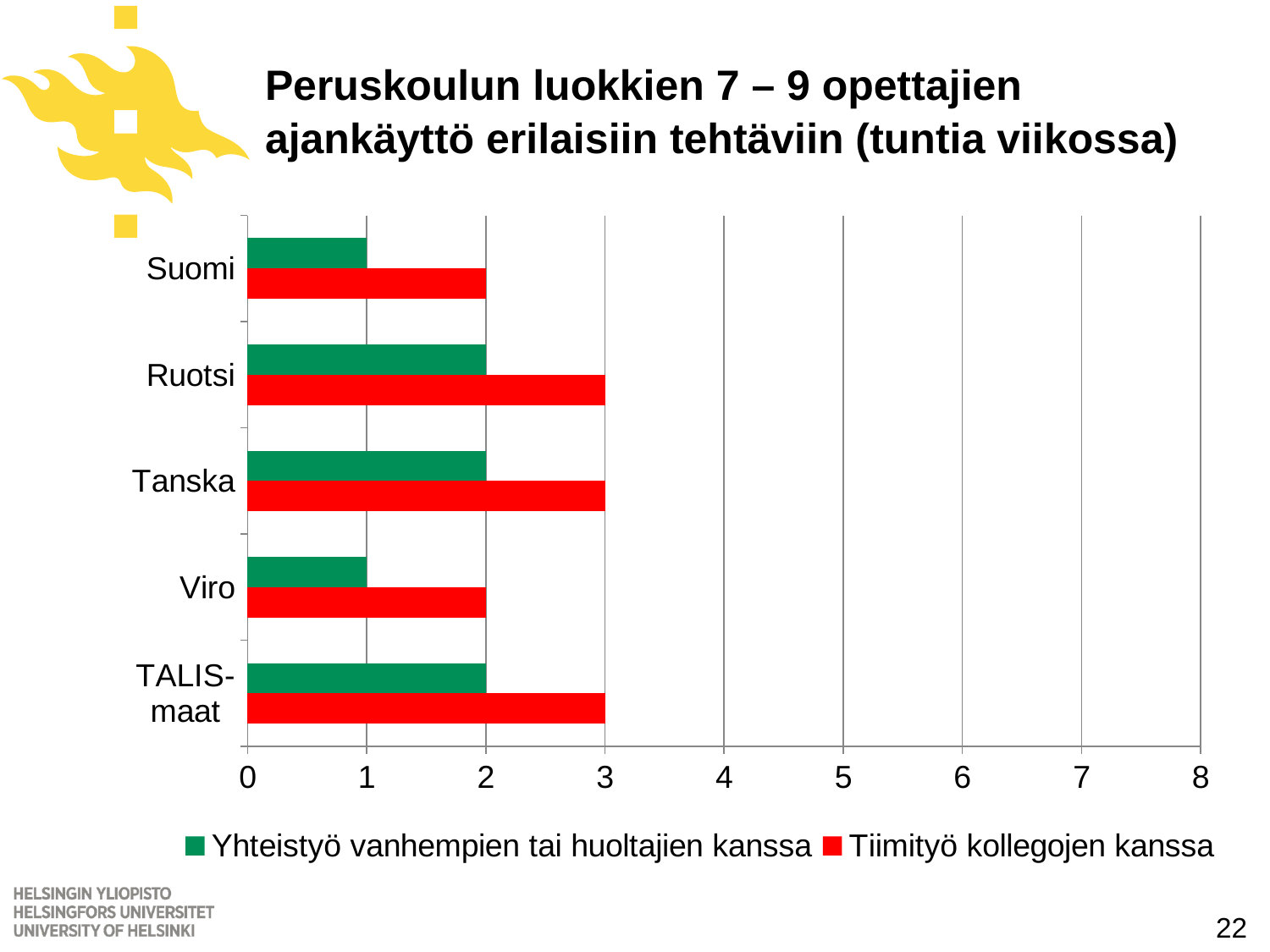
What is the highest value shown on the horizontal axis? 8 What is the value for Viro in the series 'Yhteistyö vanhempien tai huoltajien kanssa'? 1 What is the value for Suomi in the series 'Tiimityö kollegojen kanssa'? 2 How many series does the legend list? 2 Is the value for Ruotsi in the series 'Tiimityö kollegojen kanssa' greater or less than 4? less How many categories are shown on the vertical axis? 5 What kind of chart is shown on the slide? bar chart Which colour represents the series 'Tiimityö kollegojen kanssa' in the legend? red What is the value for TALIS-maat in the series 'Tiimityö kollegojen kanssa'? 3 What is the difference between the 'Tiimityö kollegojen kanssa' value and the 'Yhteistyö vanhempien tai huoltajien kanssa' value for Tanska? 1 Which is larger for Suomi: the value for 'Yhteistyö vanhempien tai huoltajien kanssa' or the value for 'Tiimityö kollegojen kanssa'? Tiimityö kollegojen kanssa What is the value for Ruotsi in the series 'Yhteistyö vanhempien tai huoltajien kanssa'? 2